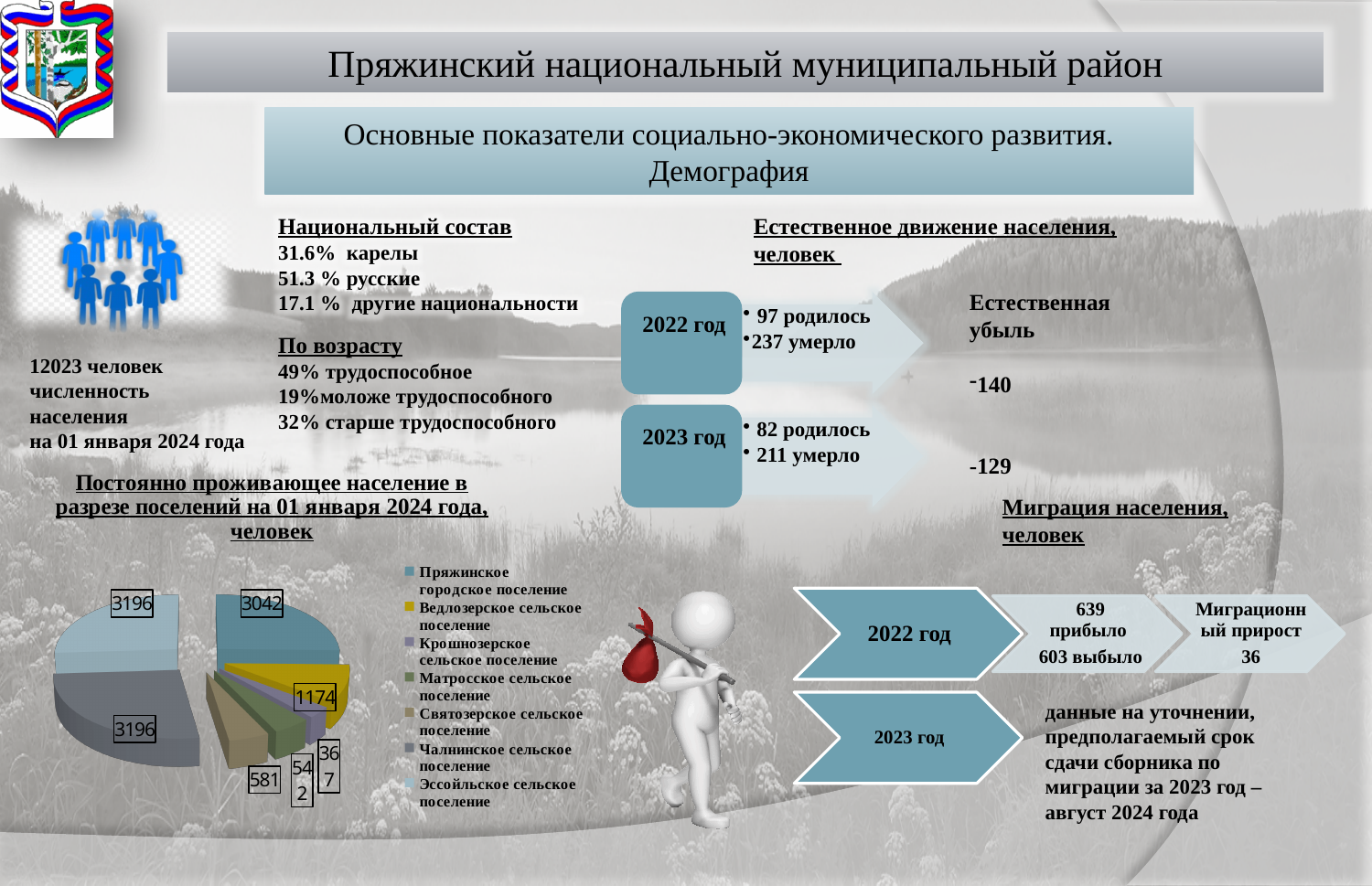
What is the title of the pie chart? Постоянно проживающее население в разрезе поселений на 01 января 2024 года, человек What is the difference between the values for Пряжинское городское поселение and Ведлозерское сельское поселение in the pie chart? 1868 What is the population value shown for Святозерское сельское поселение in the pie chart? 581 Which has the larger value in the pie chart, Ведлозерское сельское поселение or Святозерское сельское поселение? Ведлозерское сельское поселение How many settlements does the legend of the pie chart list? 7 Which has the larger value in the pie chart, Пряжинское городское поселение or Ведлозерское сельское поселение? Пряжинское городское поселение What is the population value shown for Ведлозерское сельское поселение in the pie chart? 1174 What kind of chart is shown on the slide? pie chart What is the difference between the values for Ведлозерское сельское поселение and Святозерское сельское поселение in the pie chart? 593 What is the population value shown for Пряжинское городское поселение in the pie chart? 3042 What colour is the slice for Ведлозерское сельское поселение in the pie chart? yellow